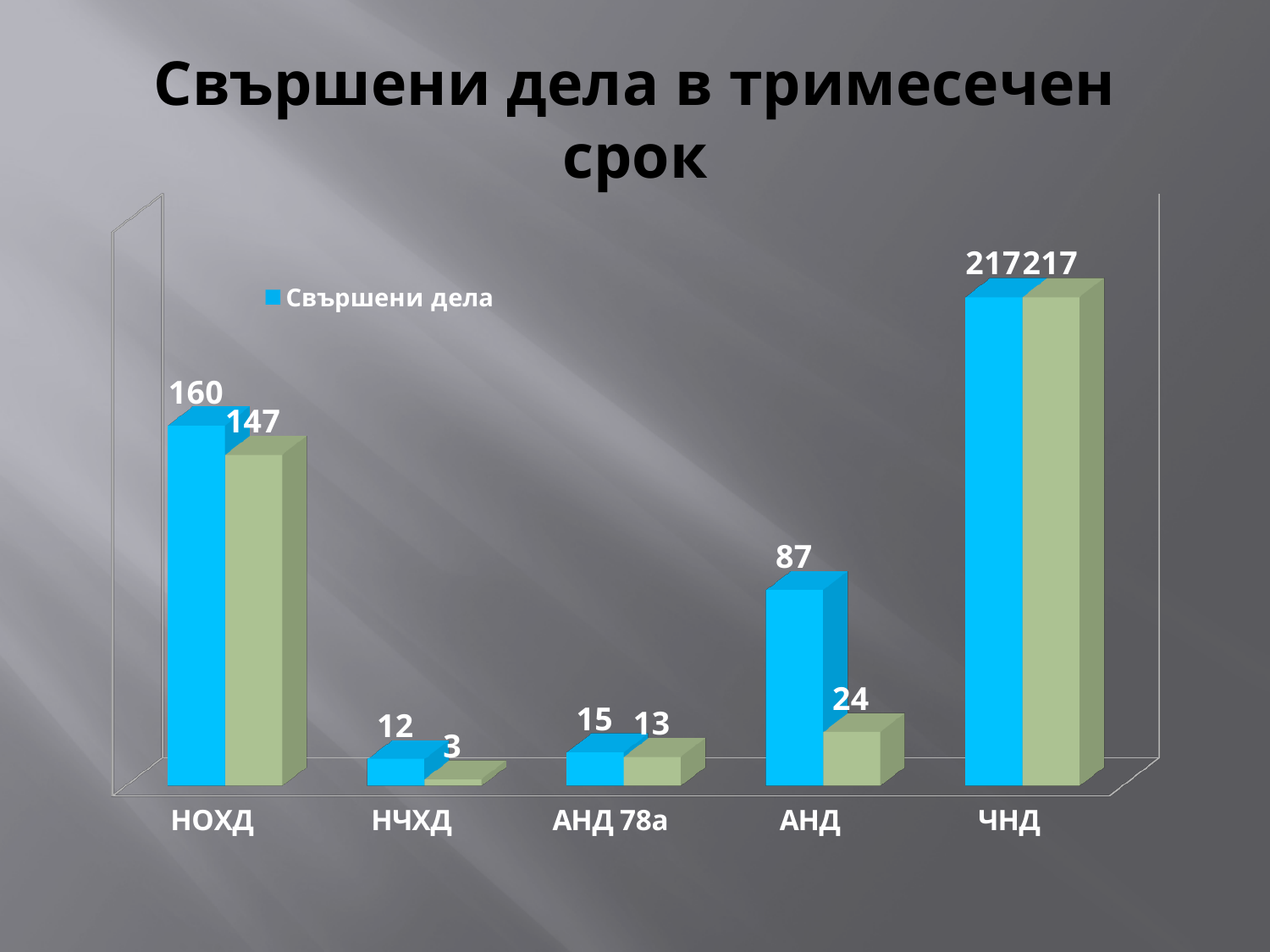
What is the value of the blue bar for НОХД? 160 Which category has the highest blue bar? ЧНД How many categories are shown on the x axis? 5 What is the value of the blue bar for АНД 78а? 15 Which is larger, the blue bar for НОХД or the green bar for НОХД? the blue bar for НОХД Which category has the lowest green bar? НЧХД What is the difference between the blue and green bars for АНД? 63 What is the difference between the blue bars for НОХД and АНД? 73 What is the value of the green bar for НЧХД? 3 What kind of chart is shown on the slide? bar chart What is the title of the chart? Свършени дела в тримесечен срок What is the value of the green bar for АНД? 24